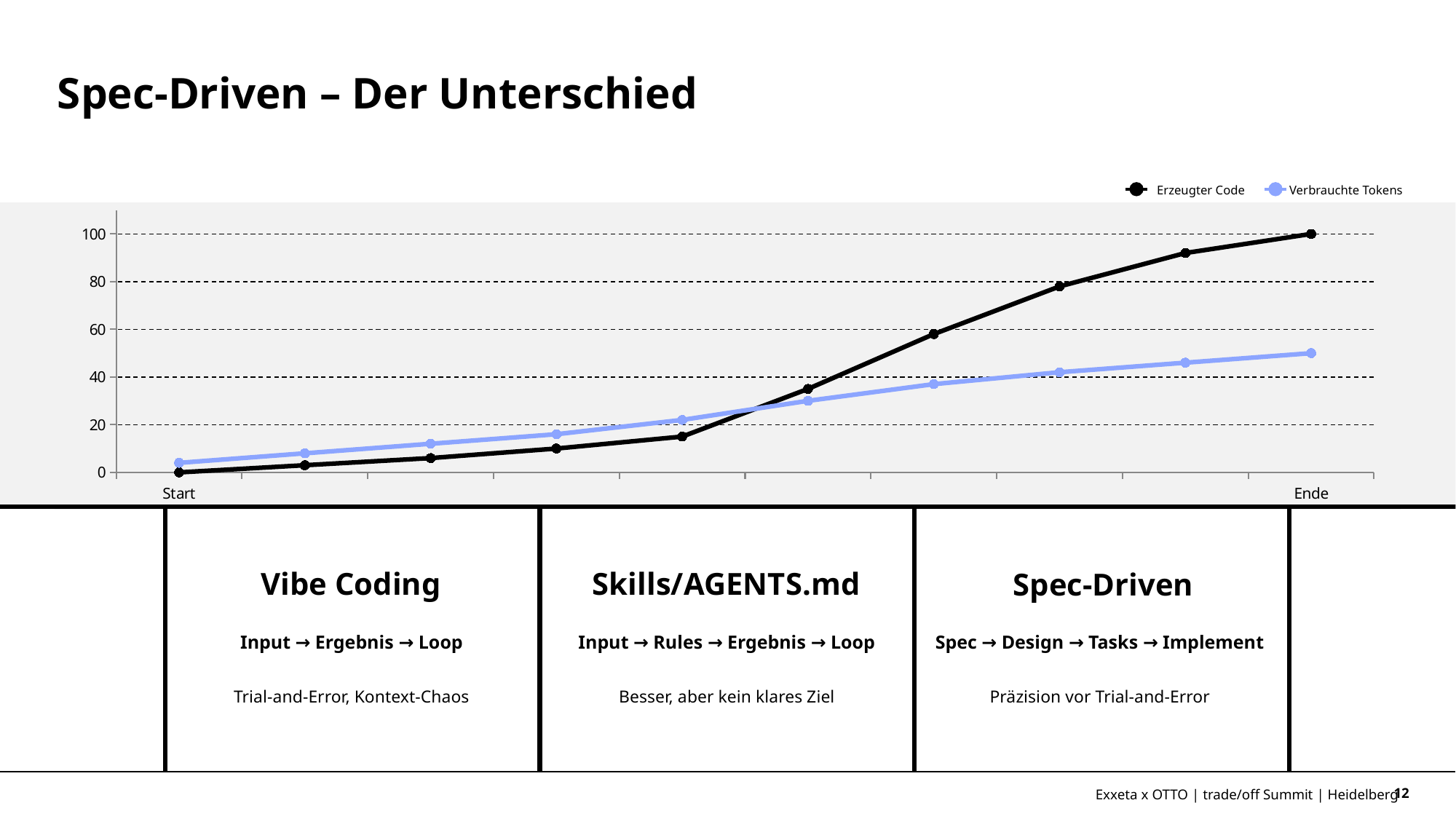
Does the Erzeugter Code line rise or fall from Start to Ende? rise How many series does the chart legend list? 2 Is the value for Verbrauchte Tokens at Ende greater or less than 60? less At Ende, which series has the higher value, Erzeugter Code or Verbrauchte Tokens? Erzeugter Code Which colour is used for the Erzeugter Code line? black What kind of chart is shown on the slide? line chart How many data points does the Erzeugter Code line have? 10 What is the value of Erzeugter Code at Ende? 100 Is the value for Verbrauchte Tokens at Ende greater or less than 40? greater What are the two series named in the chart legend? Erzeugter Code and Verbrauchte Tokens Does the Verbrauchte Tokens line rise or fall from Start to Ende? rise What is the value of Erzeugter Code at Start? 0